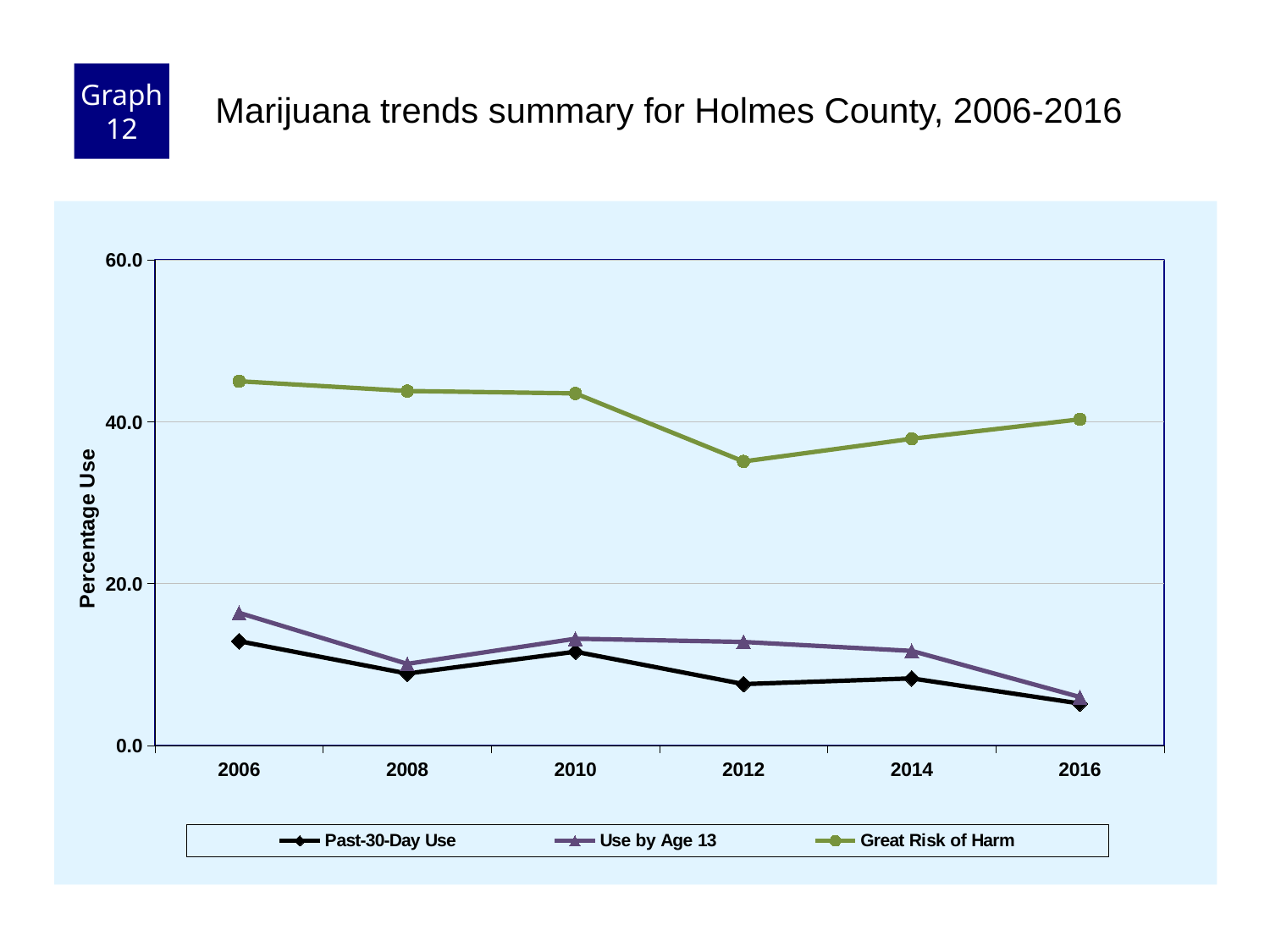
How many years are plotted along the x axis? 6 How many series does the legend list? 3 In which year is Past-30-Day Use at its lowest? 2016 What kind of chart is shown on the slide? Line chart Is the value for Use by Age 13 in 2006 greater or less than 20.0? less What is the label on the y axis? Percentage Use Is the value for Great Risk of Harm in 2006 greater or less than 40.0? greater In 2006, which is larger: Use by Age 13 or Past-30-Day Use? Use by Age 13 In which year is Use by Age 13 at its highest? 2006 Does Great Risk of Harm rise or fall from 2012 to 2016? Rise In which year is Great Risk of Harm at its lowest? 2012 Is the value for Great Risk of Harm in 2012 greater or less than 40.0? less